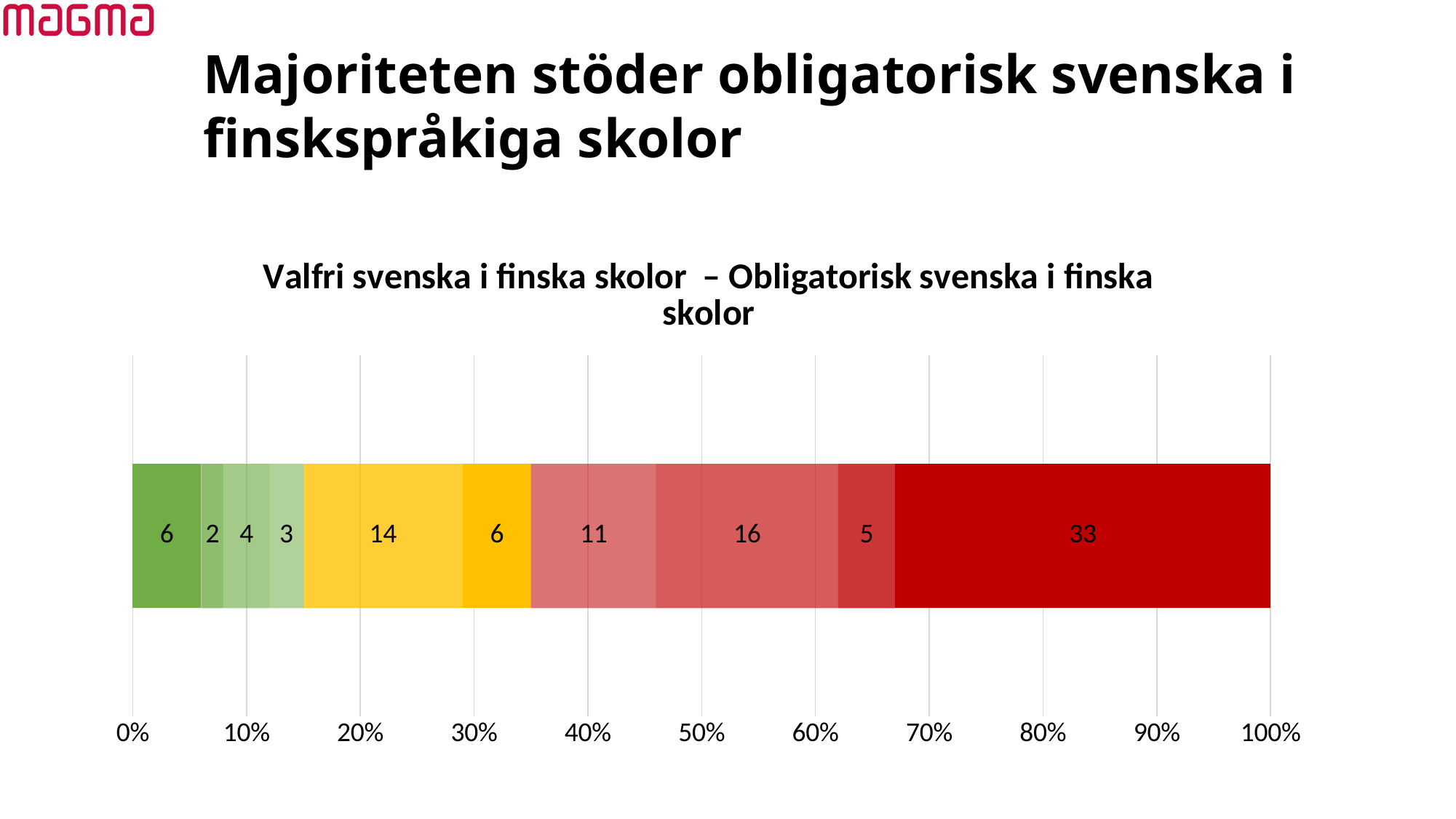
How many segments make up the stacked bar? 10 What is the difference between the largest segment (33) and the segment labelled 16? 17 What is the value of the smallest segment in the bar? 2 How many segments have a value greater than 10? 4 What kind of chart is shown on the slide? Stacked bar chart What are the values of the two yellow segments, from left to right? 14 and 6 What is the value of the leftmost (dark green) segment of the bar? 6 What is the total of all the segment values in the stacked bar? 100 Which is larger: the segment labelled 14 or the segment labelled 11? 14 What is the value of the rightmost (dark red) segment of the bar? 33 What is the value of the largest segment in the bar? 33 What is the title of the chart? Valfri svenska i finska skolor – Obligatorisk svenska i finska skolor